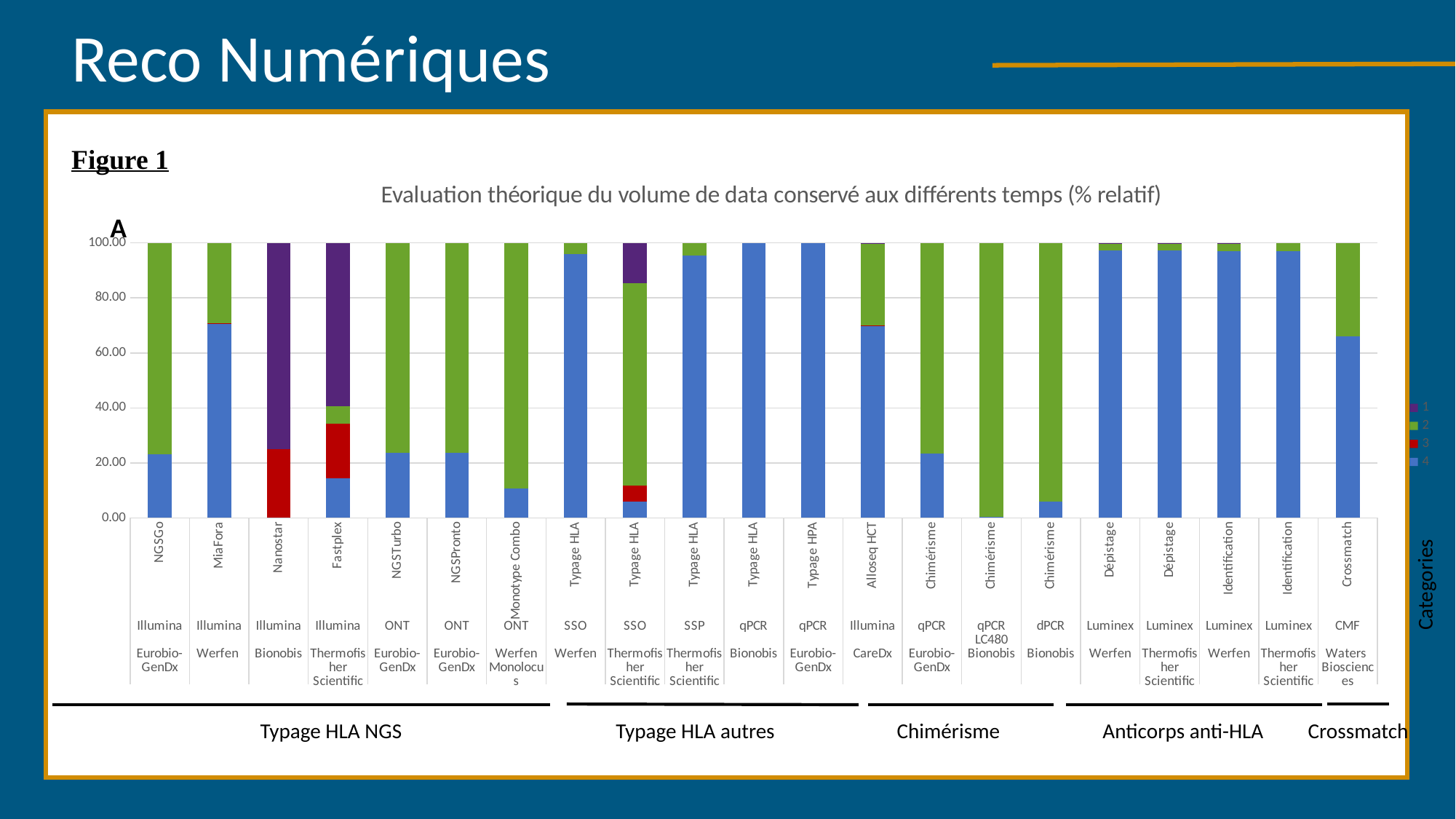
How many series does the legend of the chart list? 4 Is the value of series 4 for MiaFora greater or less than 60? greater Is the value of series 4 for Crossmatch (CMF, Waters Biosciences) greater or less than 60? greater How many category groups are labelled beneath the chart (Typage HLA NGS, Typage HLA autres, etc.)? 5 Is the value of series 1 for Nanostar greater or less than 60? greater Which bar has the largest value for series 1? Nanostar Which has the larger value for series 4: NGSGo or MiaFora? MiaFora How many bars are plotted in the chart? 21 What is the title of the chart? Evaluation théorique du volume de data conservé aux différents temps (% relatif) What kind of chart is shown in Figure 1? stacked bar chart